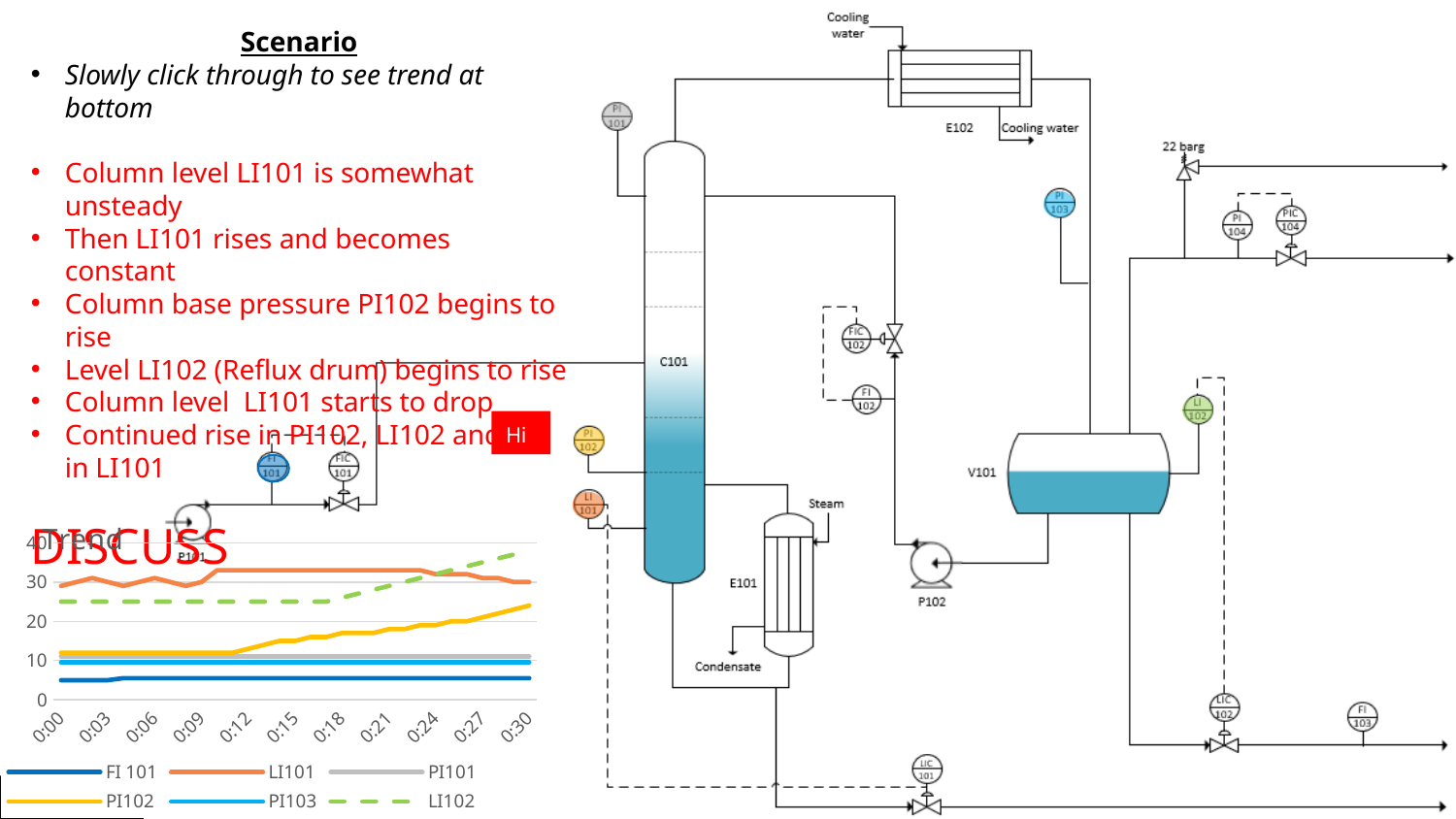
In the line chart, is the value of PI102 at 0:00 greater or less than 20? less In the line chart, does the LI102 series rise or fall between 0:18 and 0:30? Rises In the line chart, which is larger at 0:30: LI102 or PI102? LI102 How many time labels are shown along the x axis of the line chart? 11 In the line chart, which series has the highest value at 0:00? LI101 In the line chart, does the PI102 series rise or fall from 0:00 to 0:30? Rises How many series does the legend of the line chart list? 6 In the line chart, which series has the lowest value at 0:00? FI 101 In the line chart, which series is drawn with a dashed green line? LI102 In the line chart, is the value of LI101 at 0:00 greater or less than 20? greater What kind of chart is shown at the bottom left of the slide? Line chart In the line chart, is the value of FI 101 at 0:30 greater or less than 10? less